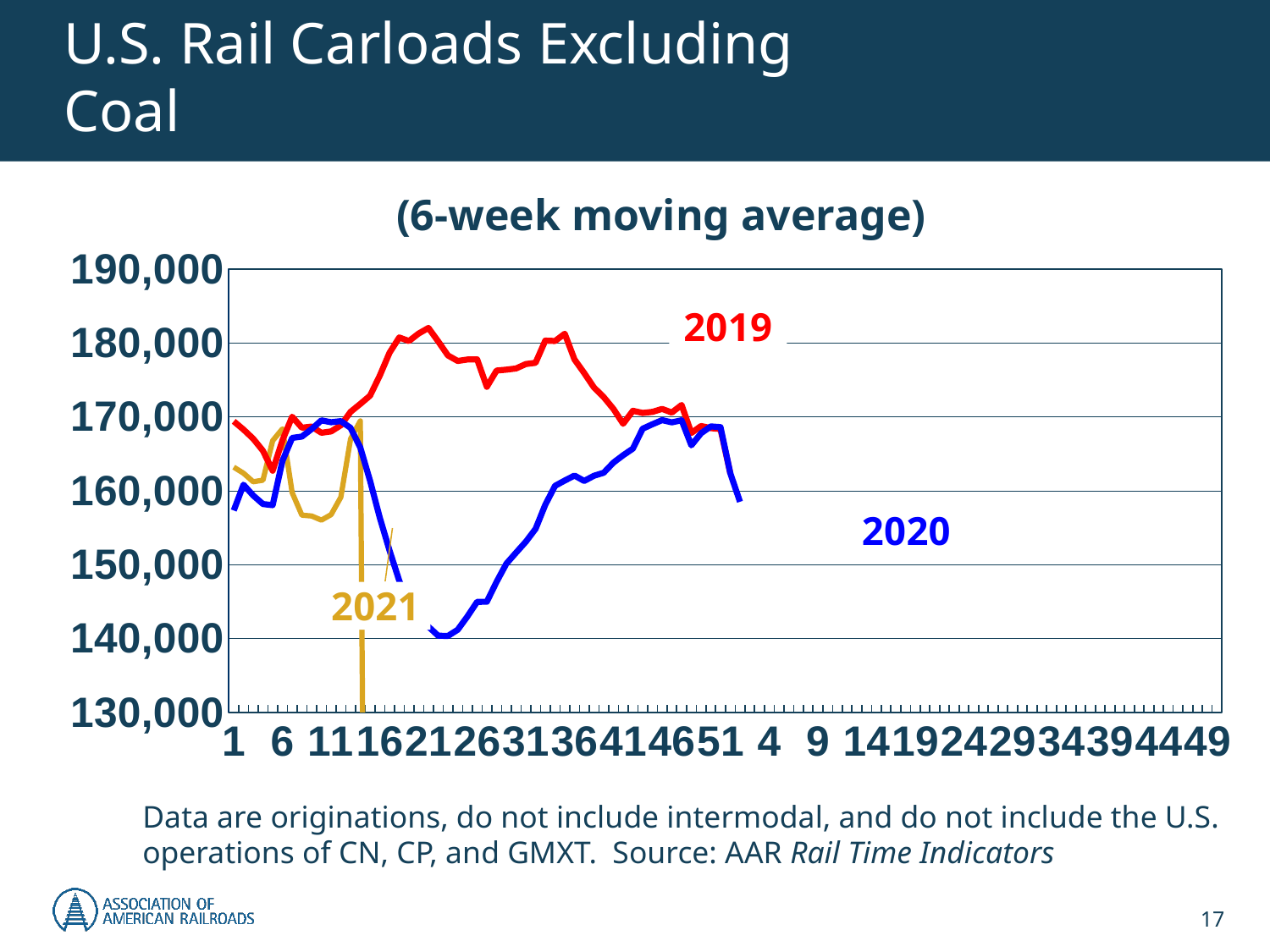
Is the value of the 2019 line at week 36 greater or less than 170,000? greater At week 21, which line is higher, 2019 or 2020? 2019 What colour is the 2020 line? blue How many data series (years) are plotted on the chart? 3 Is the lowest value of the 2020 line greater or less than 150,000? less Does the 2020 line rise or fall between week 21 and week 46? rise What is the subtitle shown above the chart? (6-week moving average) Is the peak value of the 2019 line greater or less than 180,000? greater Which year's line reaches the highest value on the chart? 2019 What kind of chart is shown on the slide? line chart